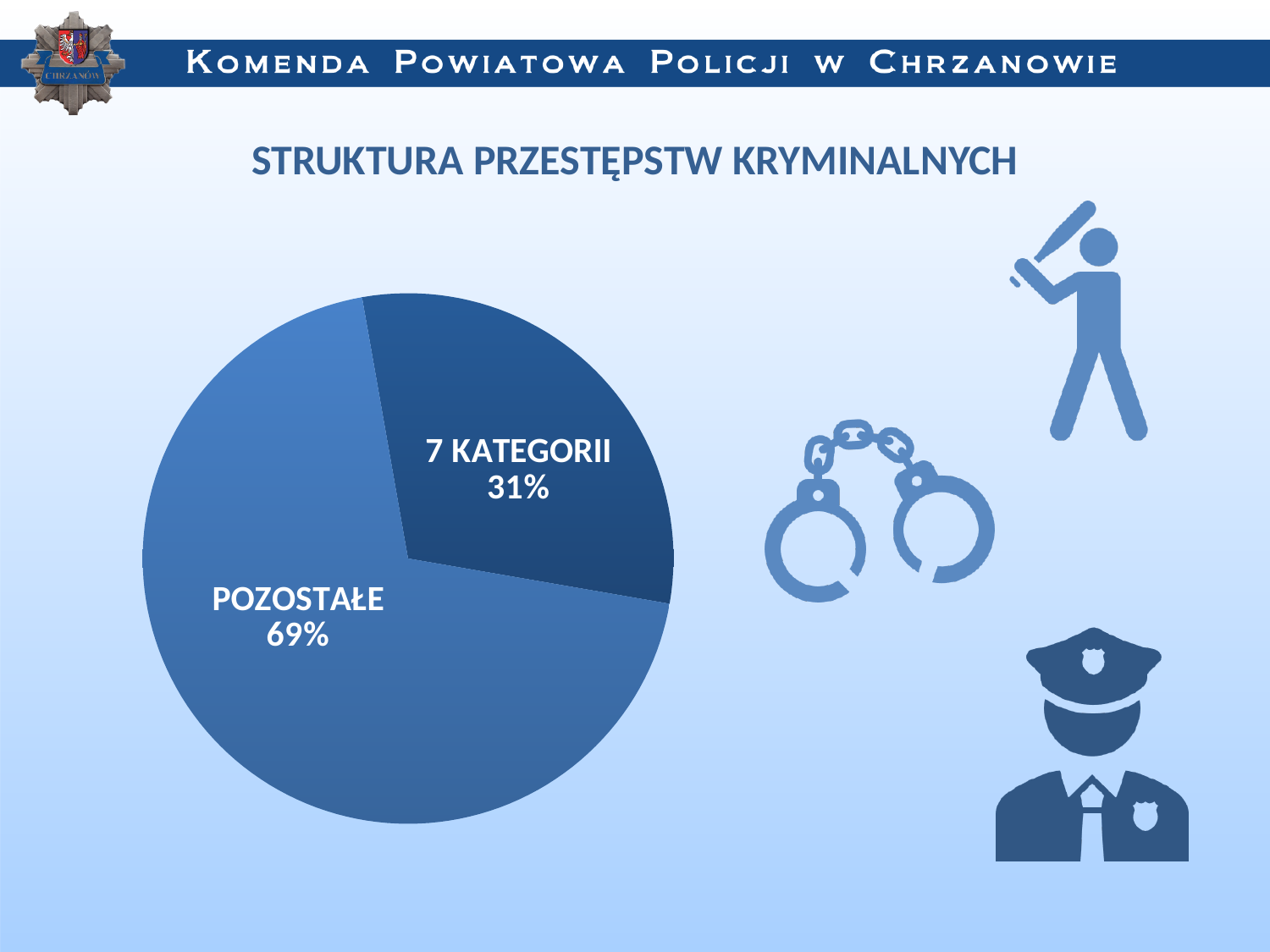
What is the difference in percentage points between the "POZOSTAŁE" and "7 KATEGORII" slices? 38 Which slice of the pie is the largest? POZOSTAŁE What share of the pie does the "POZOSTAŁE" slice represent? 69% What is the title of the chart? STRUKTURA PRZESTĘPSTW KRYMINALNYCH How many slices does the pie chart have? 2 What is the total of the two percentages shown on the pie chart? 100% Which slice of the pie is the smallest? 7 KATEGORII What share of the pie does the "7 KATEGORII" slice represent? 31% What kind of chart is shown on the slide? pie chart Which is larger, the "7 KATEGORII" slice or the "POZOSTAŁE" slice? POZOSTAŁE